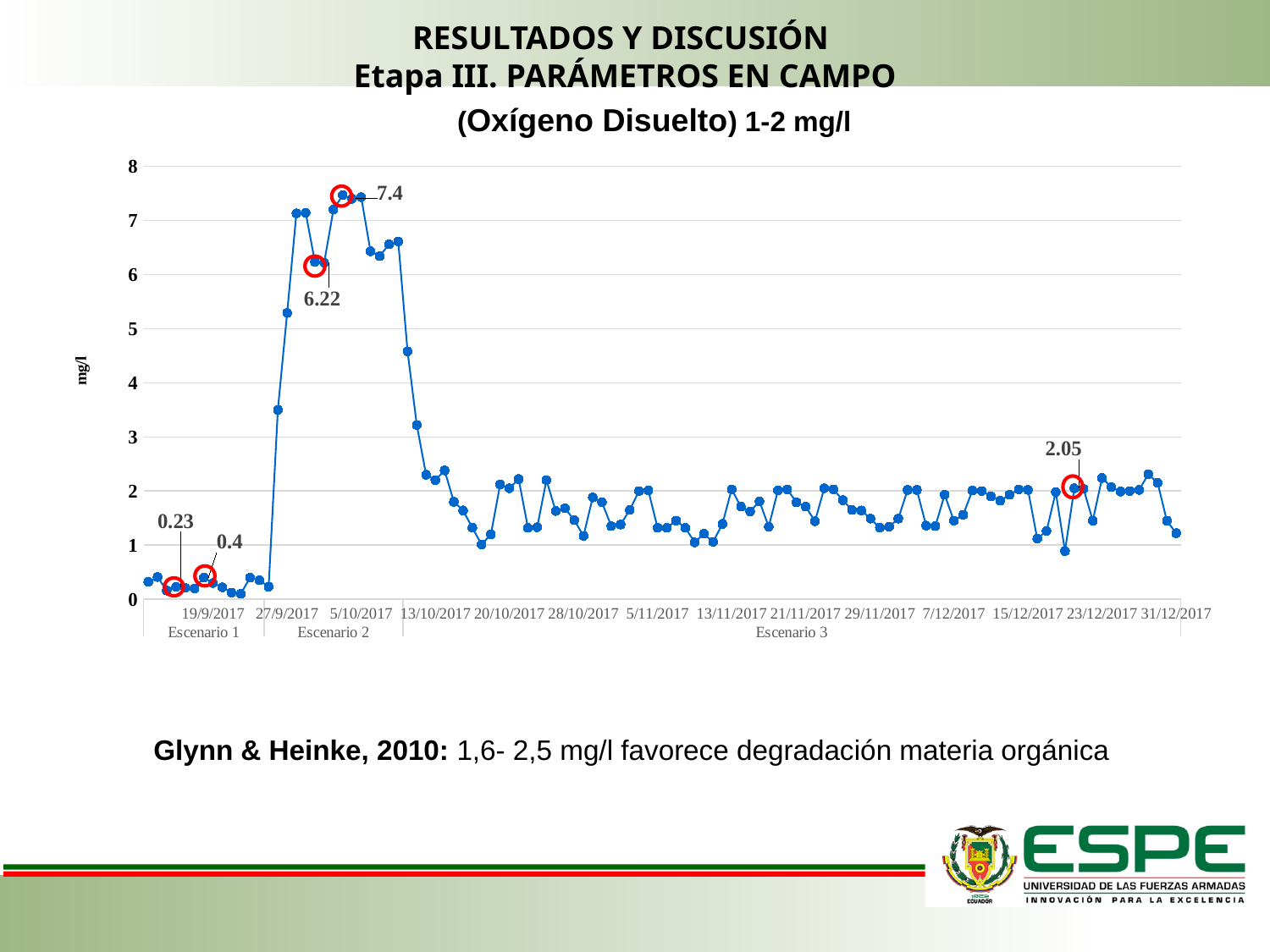
What kind of chart is shown on the slide? line chart What is the maximum value shown on the y axis? 8 Is the peak value of the line greater or less than 7? greater Which labeled value is larger, 6.22 or 7.4? 7.4 What is the highest value labeled on the chart? 7.4 What is the lowest value labeled on the chart? 0.23 What unit is shown on the y axis? mg/l Do the values rise or fall from the peak in Escenario 2 into Escenario 3? fall What is the difference between the labeled values 7.4 and 6.22? 1.18 What is the difference between the labeled values 2.05 and 0.4? 1.65 How many scenarios (Escenarios) are marked along the x axis? 3